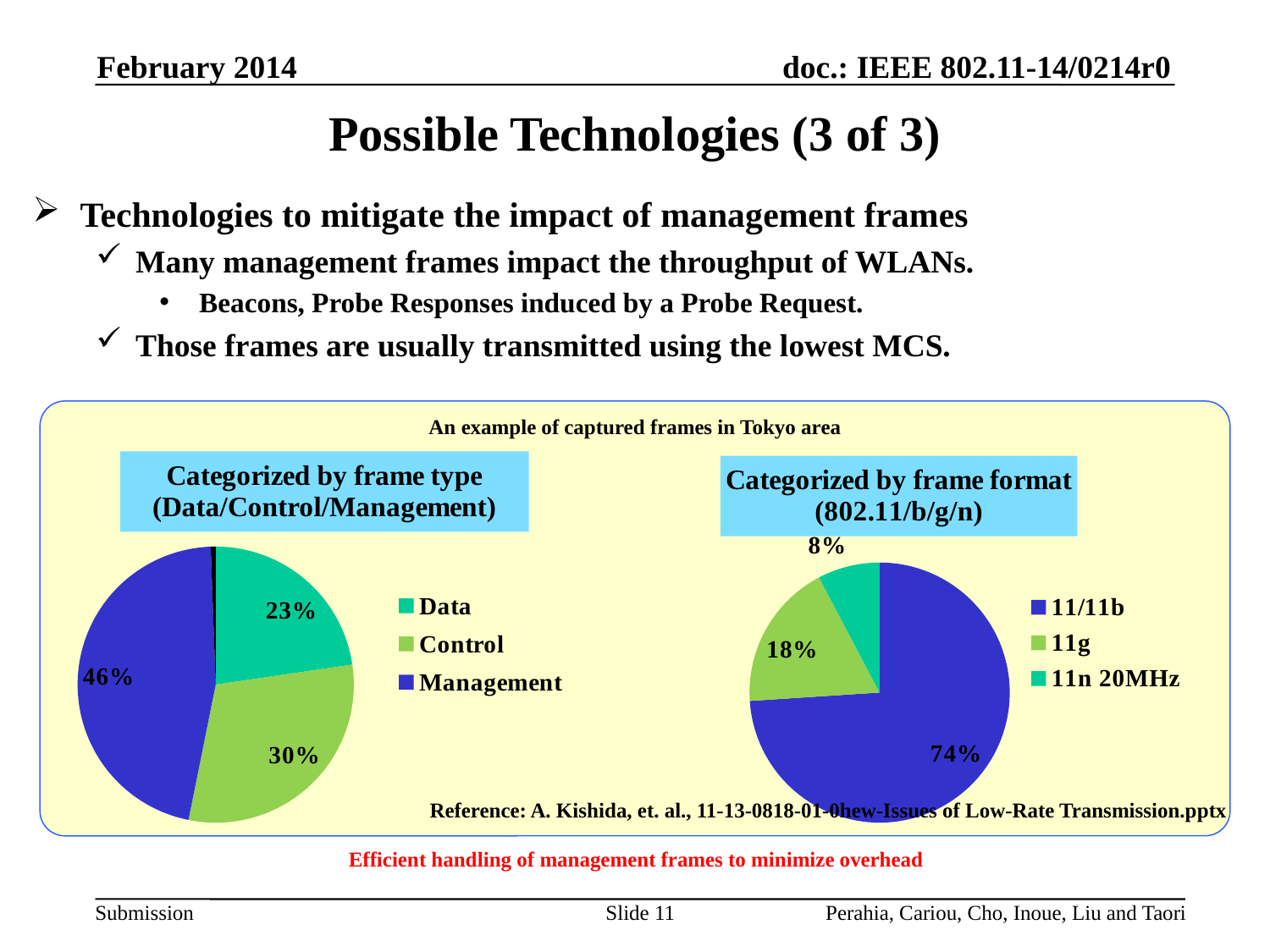
In the 'Categorized by frame format' chart, which category has the smallest share? 11n 20MHz In the 'Categorized by frame type' chart, what is the difference between the Management and Data shares? 23% In the 'Categorized by frame type' chart, what share of frames is Management? 46% In the 'Categorized by frame format' chart, what is the difference between the 11g and 11n 20MHz shares? 10% In the 'Categorized by frame type' chart, what share of frames is Data? 23% In the 'Categorized by frame type' chart, what share of frames is Control? 30% In the 'Categorized by frame type' chart, which category has the largest share? Management In the 'Categorized by frame format' chart, what share of frames is 11/11b? 74% In the 'Categorized by frame format' chart, what share of frames is 11n 20MHz? 8% In the 'Categorized by frame type' chart, which of the three labelled categories has the smallest share? Data In the 'Categorized by frame format' chart, what share of frames is 11g? 18% What kind of chart is the 'Categorized by frame format' chart? Pie chart